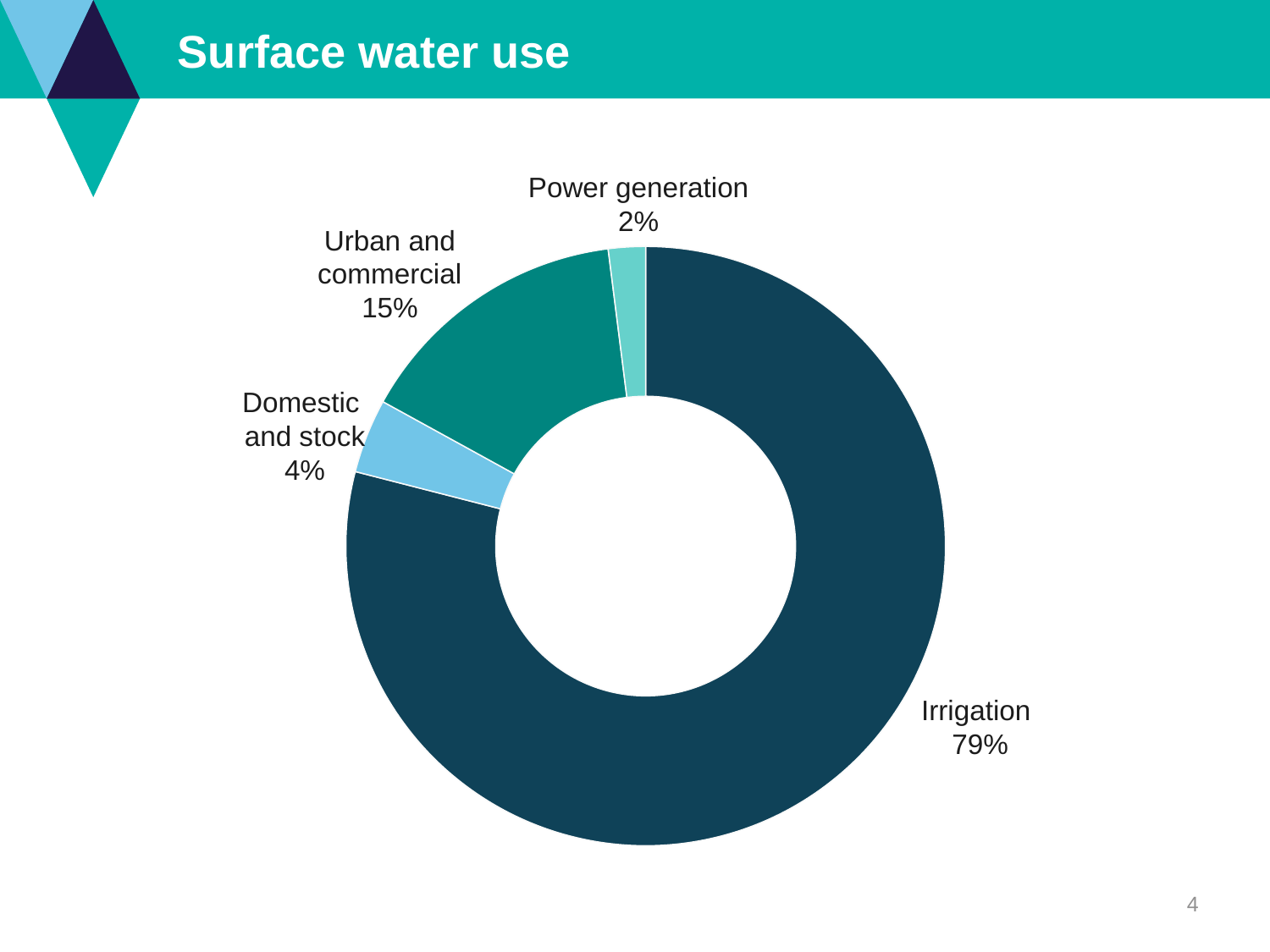
What share of surface water use is Irrigation? 79% What is the title of the slide? Surface water use What share of surface water use is Power generation? 2% How many categories are shown in the chart? 4 Which category has the smallest share of surface water use? Power generation What share of surface water use is Urban and commercial? 15% What kind of chart is shown on the slide? Pie chart (doughnut) What share of surface water use is Domestic and stock? 4% Which category has the largest share of surface water use? Irrigation How many percentage points larger is the Irrigation share than the Urban and commercial share? 64 What is the difference in percentage points between Domestic and stock and Power generation? 2 Which is larger, the share for Urban and commercial or the share for Domestic and stock? Urban and commercial